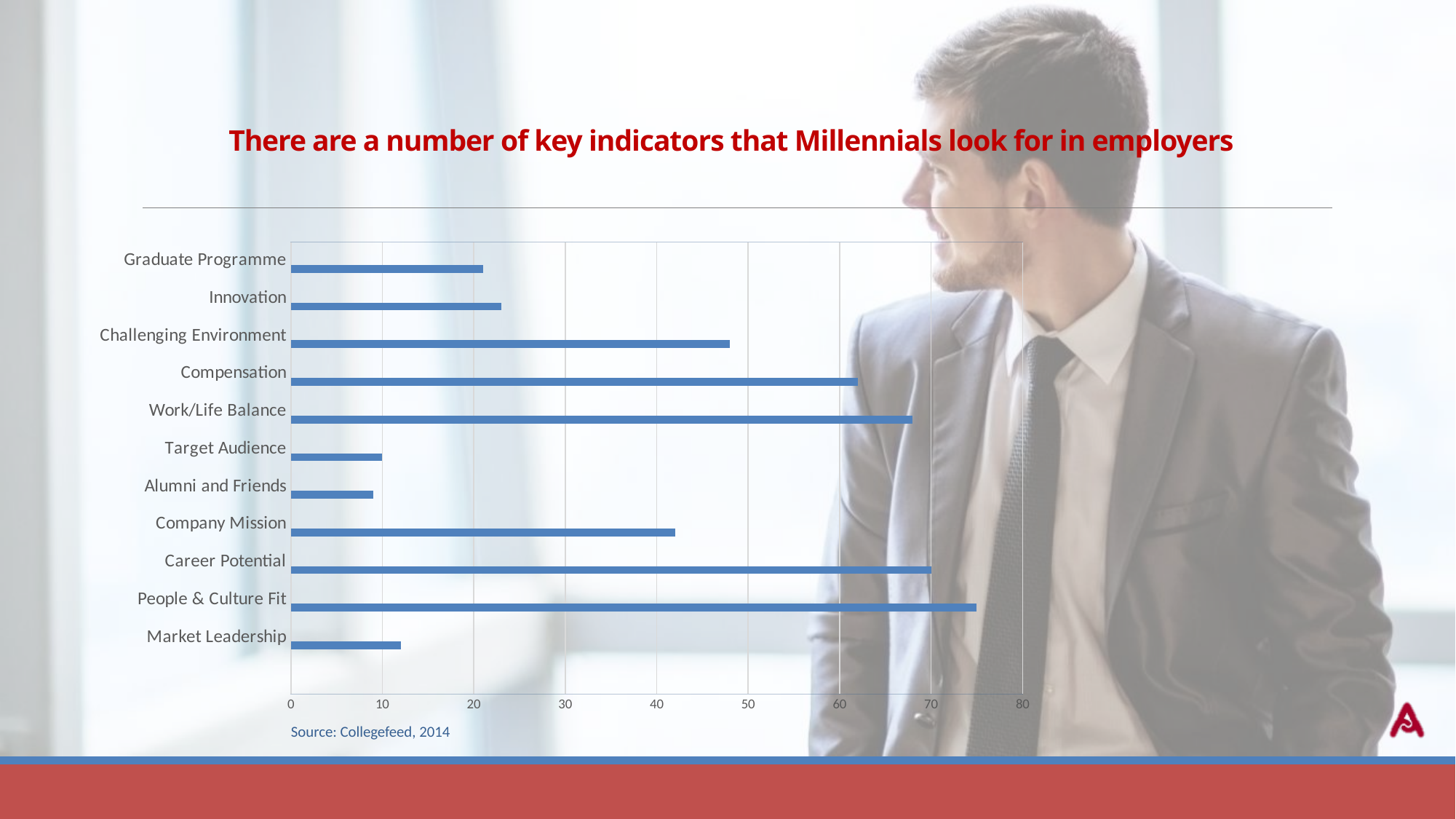
Is the value for Work/Life Balance greater or less than 60? greater Which category has the highest value in the chart? People & Culture Fit Is the value for Compensation greater or less than 70? less Which is larger, the value for Work/Life Balance or the value for Compensation? Work/Life Balance Is the value for Company Mission greater or less than 50? less What source is cited below the chart? Collegefeed, 2014 Which is larger, the value for Challenging Environment or the value for Company Mission? Challenging Environment What kind of chart is shown on the slide? bar chart How many categories are plotted in the chart? 11